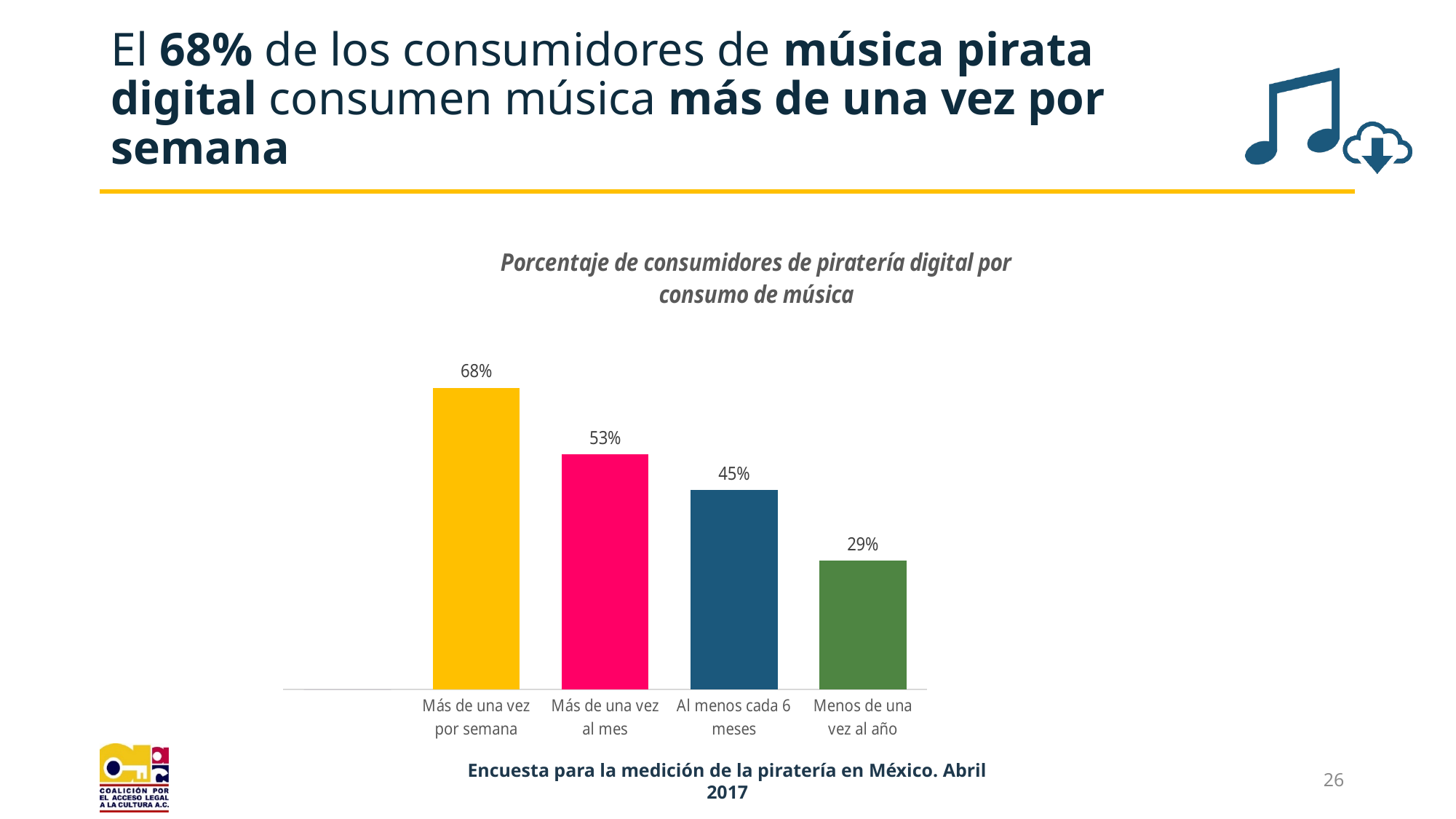
Do the values rise or fall from left to right along the x axis? Fall What is the difference between the values for "Más de una vez al mes" and "Al menos cada 6 meses"? 8% Which is larger, the value for "Más de una vez al mes" or the value for "Al menos cada 6 meses"? Más de una vez al mes Which category has the highest value? Más de una vez por semana What is the value for "Más de una vez al mes"? 53% What kind of chart is shown on the slide? Bar chart What is the value for "Más de una vez por semana"? 68% How many categories are shown in the chart? 4 What is the value for "Menos de una vez al año"? 29% What is the value for "Al menos cada 6 meses"? 45% What is the difference between the values for "Más de una vez por semana" and "Menos de una vez al año"? 39% Which category has the lowest value? Menos de una vez al año